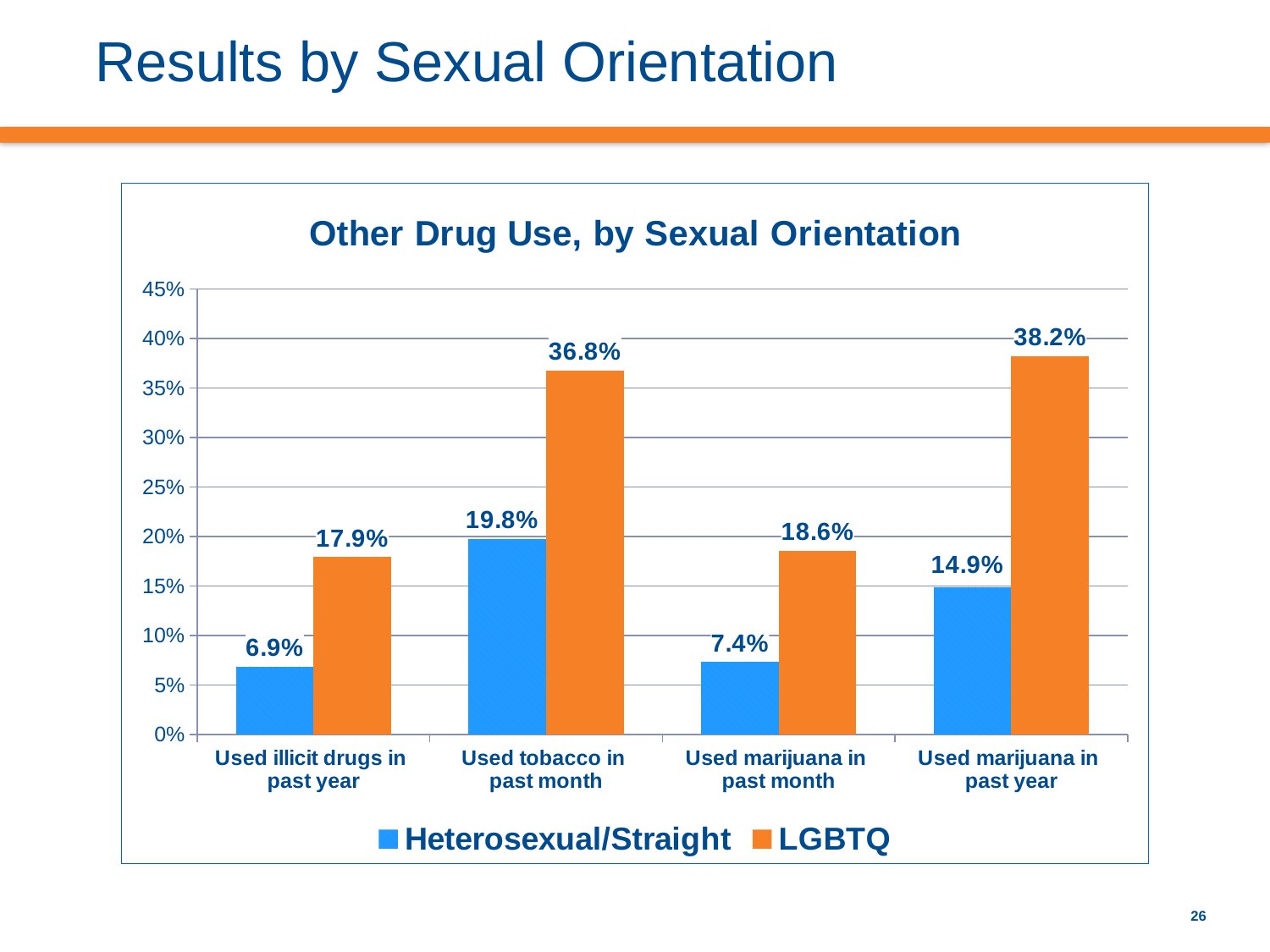
What is the value for Heterosexual/Straight for 'Used illicit drugs in past year'? 6.9% What kind of chart is shown? Bar chart How many series does the legend list? 2 What is the title of the chart? Other Drug Use, by Sexual Orientation What is the value for Heterosexual/Straight for 'Used marijuana in past year'? 14.9% Which category has the lowest Heterosexual/Straight value? Used illicit drugs in past year Is the LGBTQ value for 'Used illicit drugs in past year' greater or less than 20%? less What is the value for LGBTQ for 'Used tobacco in past month'? 36.8% Which is larger for 'Used marijuana in past month': the Heterosexual/Straight value or the LGBTQ value? LGBTQ Which category has the highest LGBTQ value? Used marijuana in past year What is the difference between the LGBTQ and Heterosexual/Straight values for 'Used marijuana in past year'? 23.3% How many categories are shown on the x axis? 4